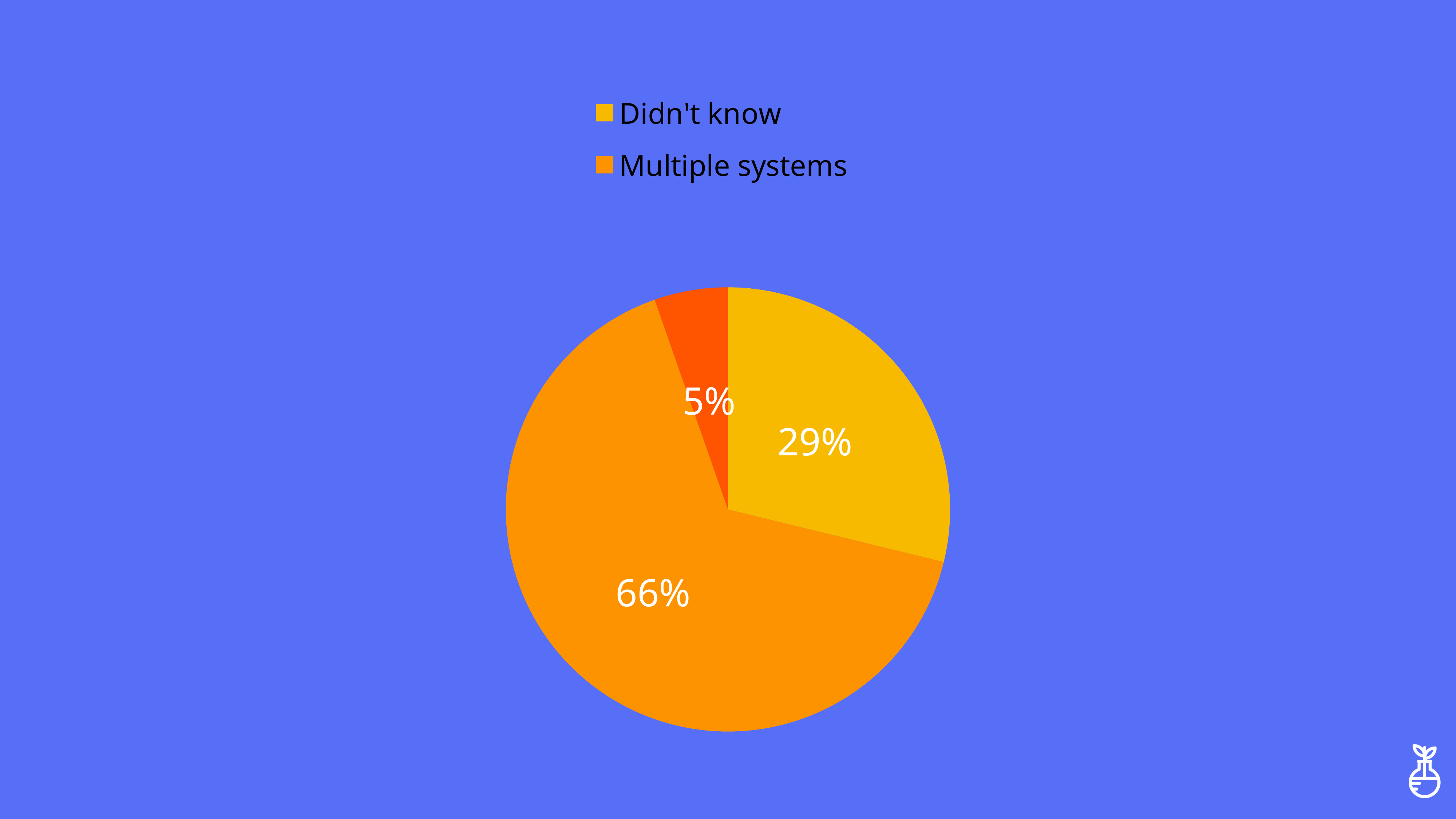
What is the value shown on the smallest slice of the pie? 5% What percentage of the pie is labelled "Didn't know"? 29% How many slices does the pie chart have? 3 What percentage of the pie is labelled "Multiple systems"? 66% Is the "Multiple systems" slice more or less than half of the pie? more What kind of chart is shown on the slide? pie chart How many entries does the legend list? 2 Which is larger, the "Didn't know" slice or the "Multiple systems" slice? Multiple systems What is the difference in percentage points between the "Didn't know" slice and the 5% slice? 24 What colour is the "Didn't know" slice? yellow Which legend category has the largest slice of the pie? Multiple systems What is the difference in percentage points between the "Multiple systems" slice and the "Didn't know" slice? 37